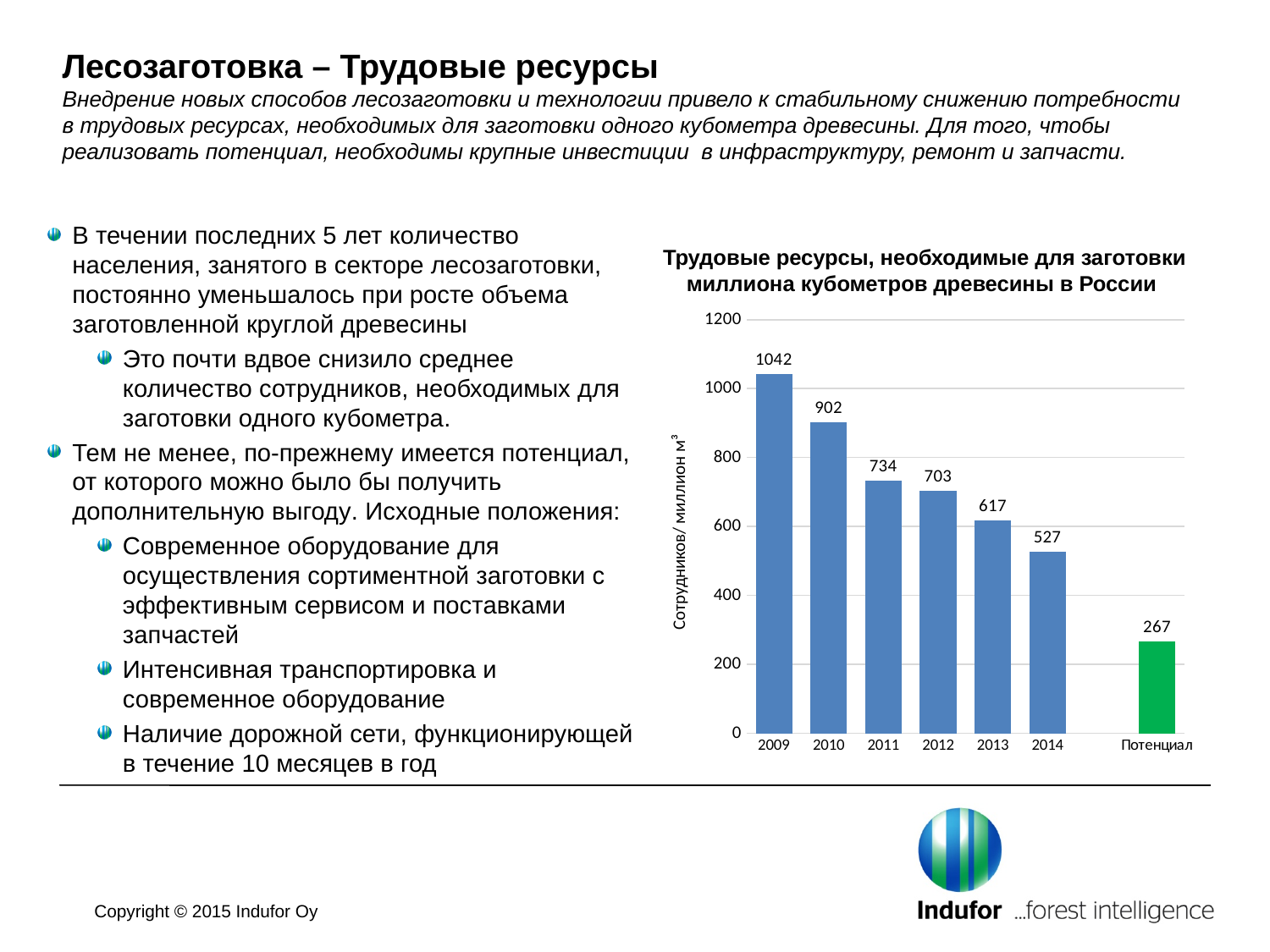
How many categories are shown on the x axis? 7 Which category has the highest value? 2009 Do the values rise or fall from 2009 to 2014? fall What is the difference between the values for 2011 and 2012? 31 What is the value for Потенциал? 267 What is the difference between the values for 2009 and 2014? 515 What is the title of the chart? Трудовые ресурсы, необходимые для заготовки миллиона кубометров древесины в России What kind of chart is this? bar chart Which is larger, the value for 2010 or the value for 2013? 2010 What is the value for 2009? 1042 What is the value for 2012? 703 Which category has the lowest value? Потенциал